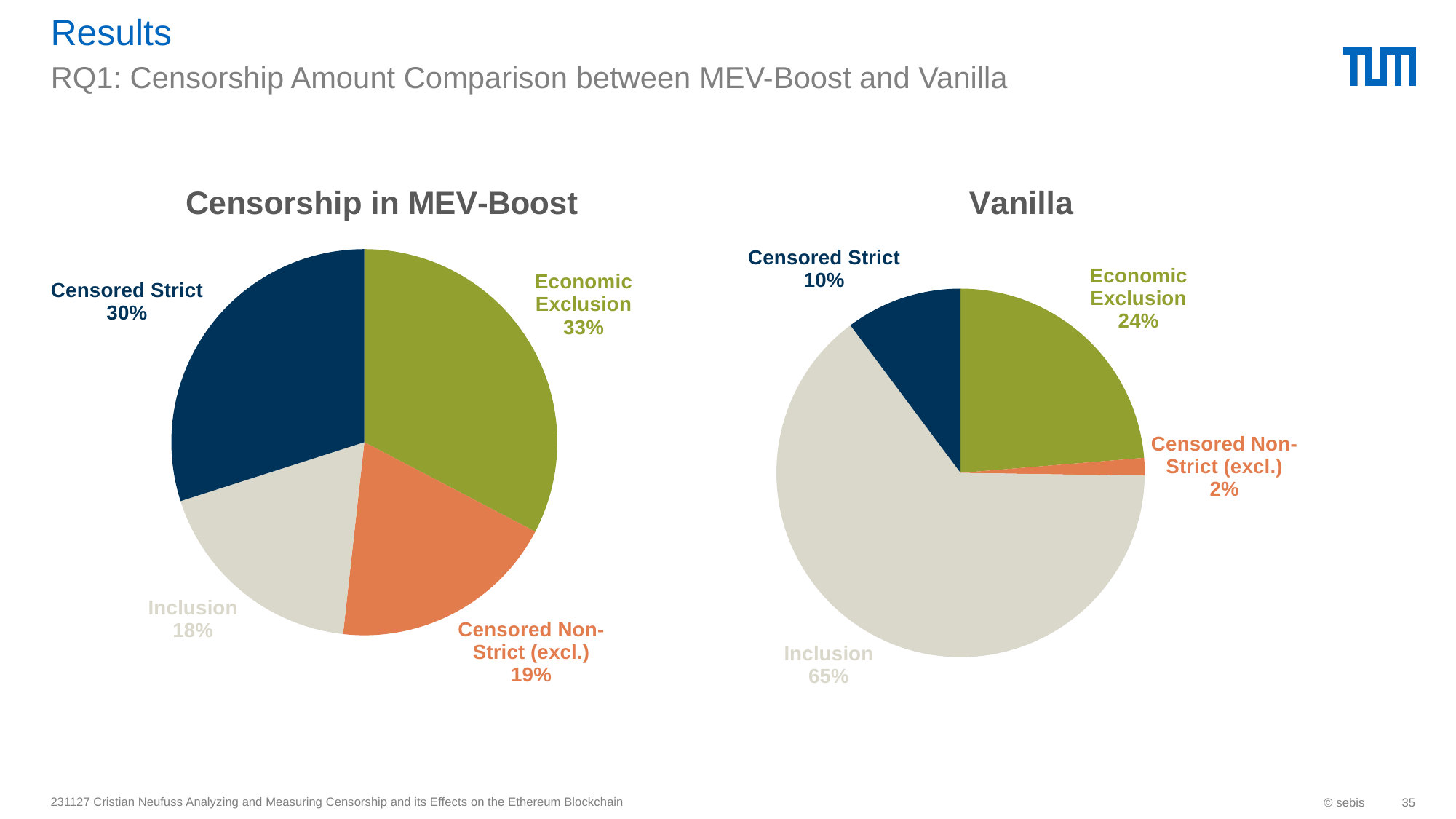
What is the title of the pie chart on the left of the slide? Censorship in MEV-Boost In the 'Vanilla' chart, what share does Censored Strict have? 10% In the 'Censorship in MEV-Boost' chart, what share does Economic Exclusion have? 33% In the 'Vanilla' chart, which category has the smallest share? Censored Non-Strict (excl.) In the 'Censorship in MEV-Boost' chart, which category has the largest share? Economic Exclusion In the 'Vanilla' chart, what share does Inclusion have? 65% How many slices does the 'Vanilla' pie chart have? 4 In the 'Vanilla' chart, what is the difference in percentage points between Inclusion and Economic Exclusion? 41 In the 'Censorship in MEV-Boost' chart, which is larger: Censored Strict or Censored Non-Strict (excl.)? Censored Strict What type of chart is 'Censorship in MEV-Boost'? Pie chart In the 'Censorship in MEV-Boost' chart, which category has the smallest share? Inclusion In the 'Censorship in MEV-Boost' chart, what colour is the Inclusion slice? Light grey